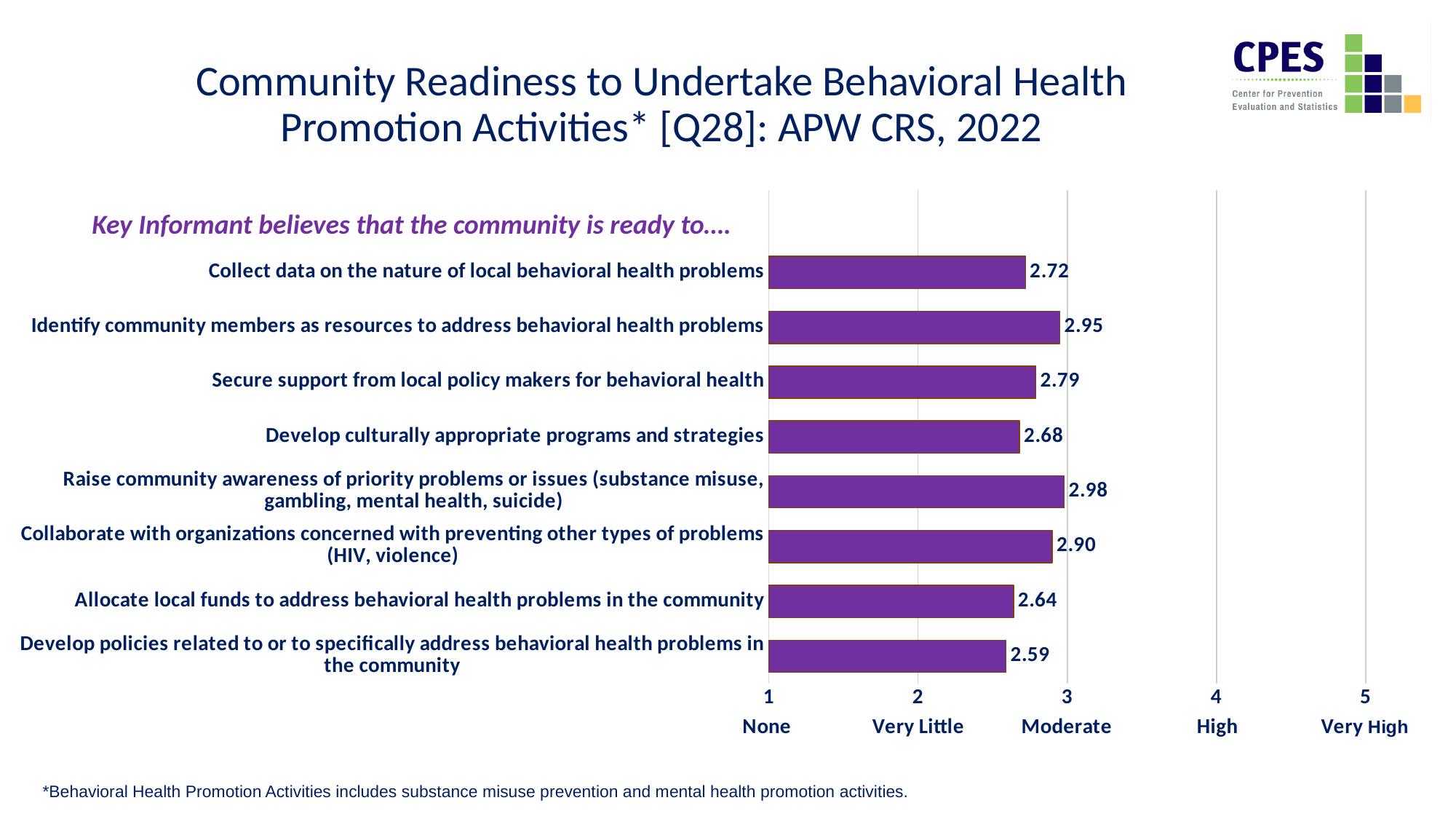
What is the value for "Collect data on the nature of local behavioral health problems"? 2.72 What label does the x axis show at the value 3? Moderate What is the value for "Secure support from local policy makers for behavioral health"? 2.79 How many categories are shown in the chart? 8 Which category has the highest value? Raise community awareness of priority problems or issues (substance misuse, gambling, mental health, suicide) What is the difference between the values for "Identify community members as resources to address behavioral health problems" and "Develop culturally appropriate programs and strategies"? 0.27 Which category has the lowest value? Develop policies related to or to specifically address behavioral health problems in the community What is the value for "Allocate local funds to address behavioral health problems in the community"? 2.64 Is the value for "Develop policies related to or to specifically address behavioral health problems in the community" greater or less than 3? less What is the title of the chart? Community Readiness to Undertake Behavioral Health Promotion Activities* [Q28]: APW CRS, 2022 What kind of chart is shown on the slide? bar chart Which is larger: the value for "Collaborate with organizations concerned with preventing other types of problems (HIV, violence)" or the value for "Collect data on the nature of local behavioral health problems"? Collaborate with organizations concerned with preventing other types of problems (HIV, violence)